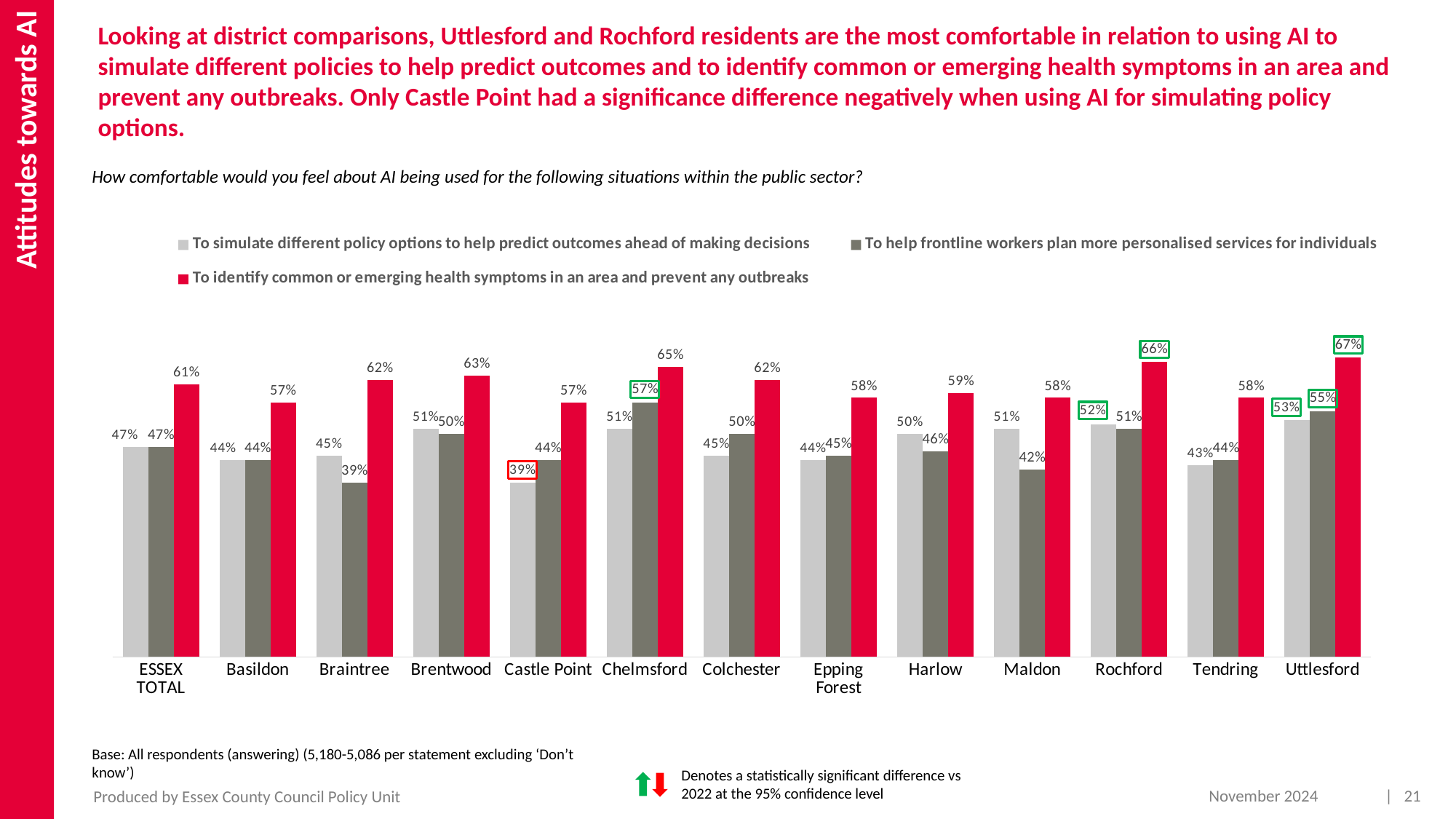
How many series does the chart's legend list? 3 Which district has the highest value for 'To help frontline workers plan more personalised services for individuals'? Chelmsford What type of chart is shown on the slide? Bar chart For Braintree, which is larger: the value for simulating different policy options or the value for helping frontline workers plan more personalised services? To simulate different policy options to help predict outcomes ahead of making decisions What is the ESSEX TOTAL value for 'To help frontline workers plan more personalised services for individuals'? 47% Which district has the highest value for 'To identify common or emerging health symptoms in an area and prevent any outbreaks'? Uttlesford What percentage of Uttlesford residents are comfortable with AI being used to identify common or emerging health symptoms in an area and prevent any outbreaks? 67% Which colour represents the series 'To identify common or emerging health symptoms in an area and prevent any outbreaks'? Red Which district has the lowest value for 'To simulate different policy options to help predict outcomes ahead of making decisions'? Castle Point What is the difference between Rochford's and Basildon's values for 'To identify common or emerging health symptoms in an area and prevent any outbreaks'? 9% What is the value for Castle Point for the series 'To simulate different policy options to help predict outcomes ahead of making decisions'? 39% How many districts (including ESSEX TOTAL) are shown on the x axis of the chart? 13